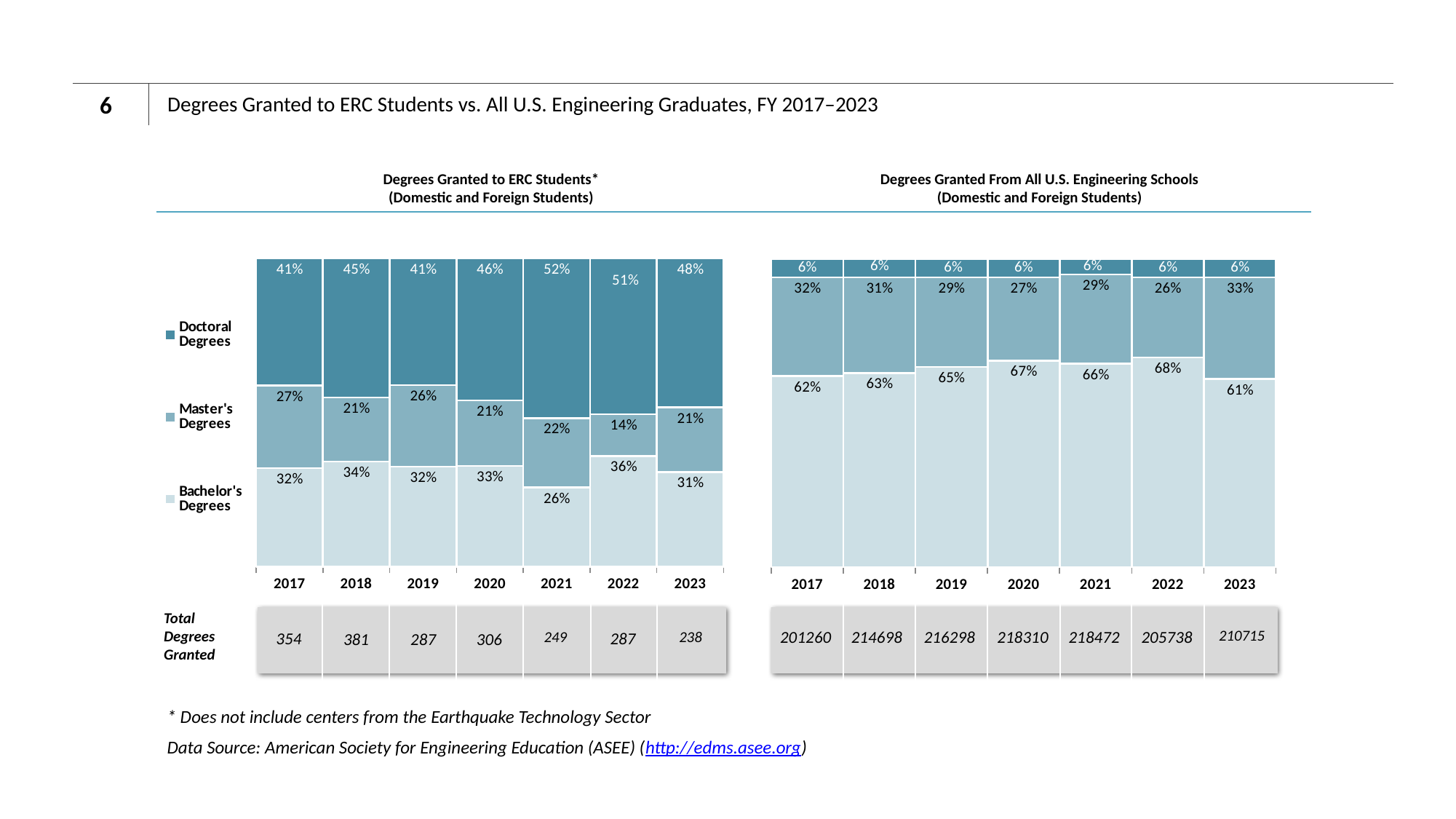
In the 'Degrees Granted to ERC Students' chart, which year has the highest Doctoral Degrees share? 2021 In the 'Degrees Granted to ERC Students' chart, what percentage of degrees in 2018 were Bachelor's Degrees? 34% In the 'Degrees Granted From All U.S. Engineering Schools' chart, what percentage of degrees in 2022 were Bachelor's Degrees? 68% In the 'Degrees Granted to ERC Students' chart, which year has the lowest Master's Degrees share? 2022 How many years are shown on the x axis of the 'Degrees Granted From All U.S. Engineering Schools' chart? 7 In the 'Degrees Granted to ERC Students' chart, what is the difference between the Doctoral Degrees share in 2021 and in 2017? 11% In the 'Degrees Granted to ERC Students' chart, is the Master's Degrees share larger in 2017 or in 2020? 2017 What kind of chart is the 'Degrees Granted to ERC Students' chart? Stacked bar chart In the 'Degrees Granted to ERC Students' chart, what percentage of degrees in 2021 were Doctoral Degrees? 52% In the 'Degrees Granted From All U.S. Engineering Schools' chart, which year has the lowest Bachelor's Degrees share? 2023 In the 'Degrees Granted From All U.S. Engineering Schools' chart, what percentage of degrees in 2023 were Master's Degrees? 33% How many series does the legend list for the charts on this slide? 3